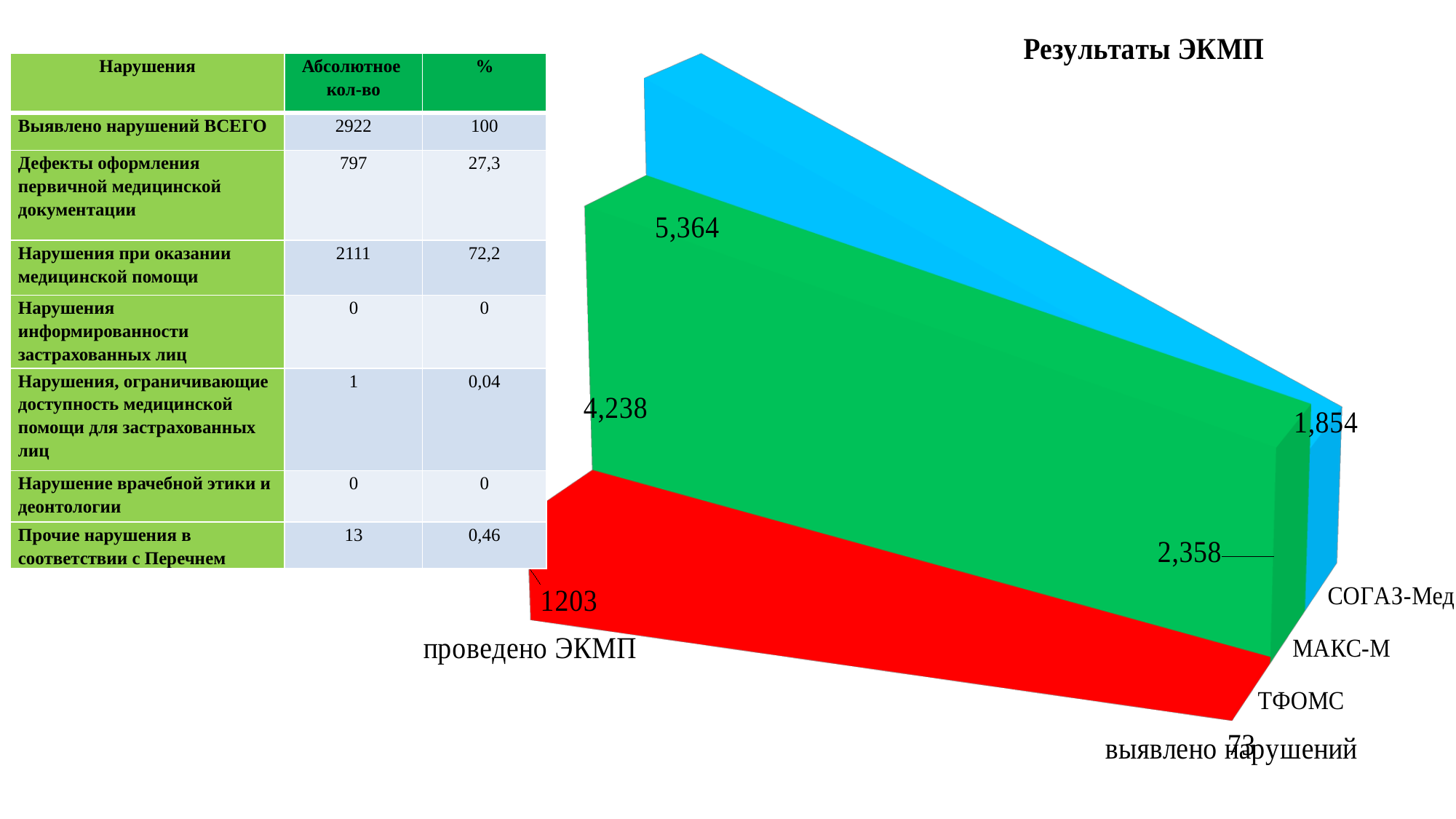
How many categories are on the x axis of the chart? 2 What is the value for ТФОМС for проведено ЭКМП? 1203 What is the value for МАКС-М for проведено ЭКМП? 4,238 What is the value for СОГАЗ-Мед for выявлено нарушений? 1,854 How many series does the chart show? 3 Do the values for МАКС-М rise or fall from проведено ЭКМП to выявлено нарушений? fall What is the value for МАКС-М for выявлено нарушений? 2,358 Which is larger for выявлено нарушений: МАКС-М or СОГАЗ-Мед? МАКС-М Which series has the highest value for проведено ЭКМП? СОГАЗ-Мед What kind of chart is shown on the slide? area chart What is the value for СОГАЗ-Мед for проведено ЭКМП? 5,364 What is the title of the chart? Результаты ЭКМП